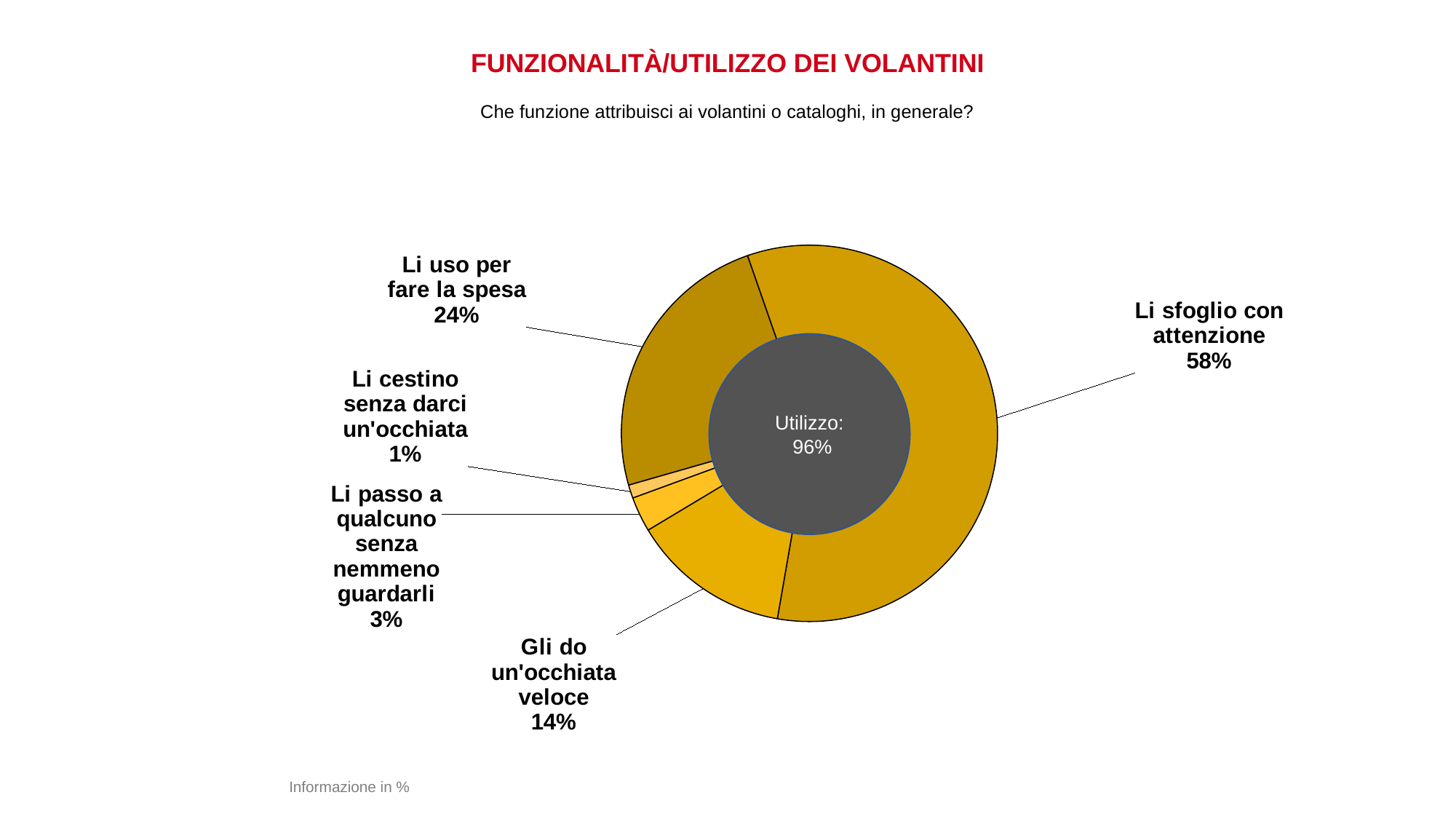
Which category has the smallest slice of the pie? Li cestino senza darci un'occhiata What is the value for "Li uso per fare la spesa"? 24% Which category has the largest slice of the pie? Li sfoglio con attenzione What is the value for "Li passo a qualcuno senza nemmeno guardarli"? 3% What text is shown in the centre of the pie chart? Utilizzo: 96% How many categories are shown in the pie chart? 5 Which is larger, "Gli do un'occhiata veloce" or "Li uso per fare la spesa"? Li uso per fare la spesa What share of the pie does "Li sfoglio con attenzione" represent? 58% What is the value for "Li cestino senza darci un'occhiata"? 1% What is the value for "Gli do un'occhiata veloce"? 14% What is the difference between "Li sfoglio con attenzione" and "Li uso per fare la spesa"? 34% What kind of chart is shown on the slide? Doughnut chart